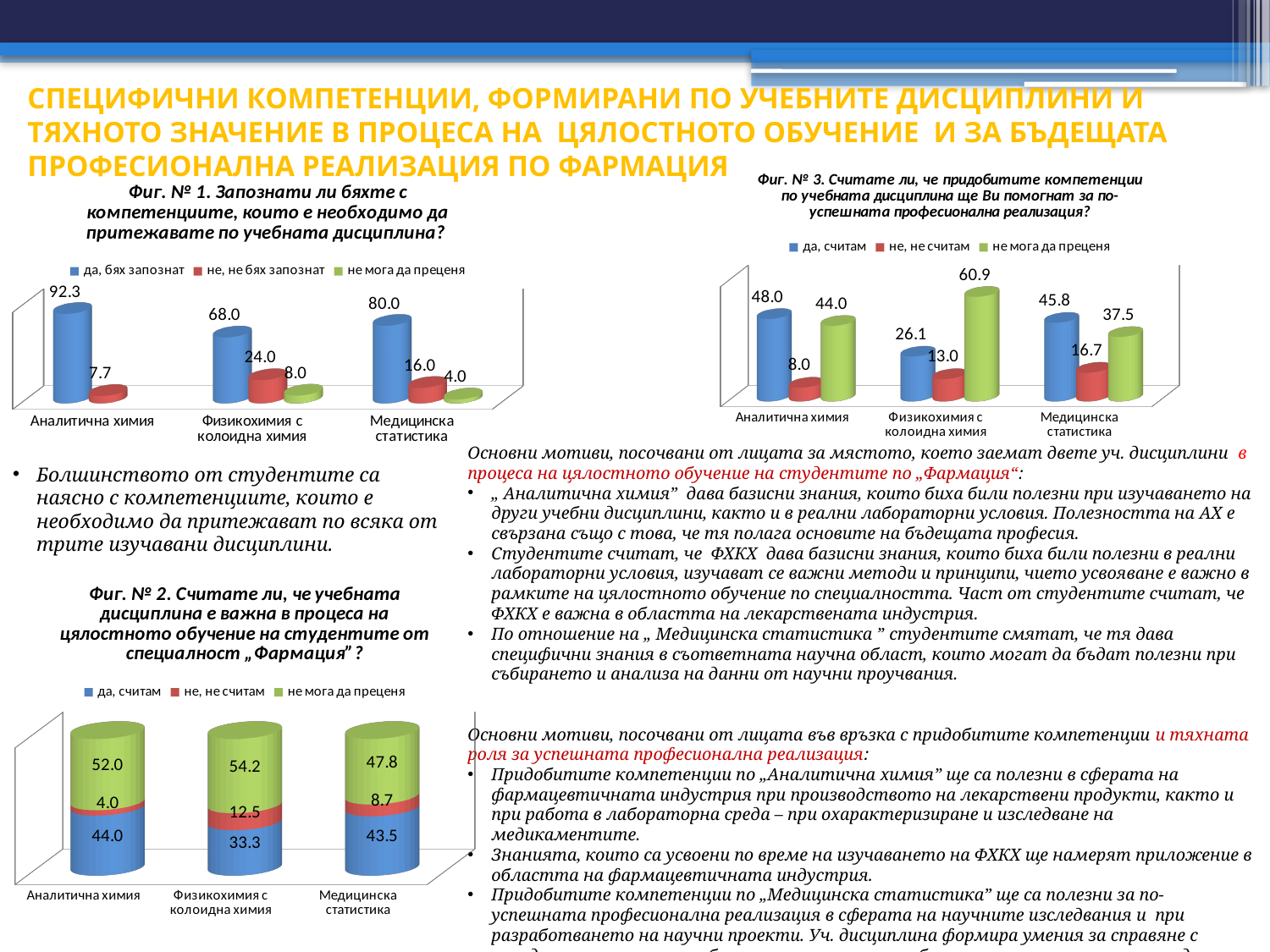
In the chart titled "Фиг. № 2" (bottom left), what is the total of the stacked bar for Аналитична химия? 100.0 In the chart titled "Фиг. № 3" (top right), which is larger for Медицинска статистика: "да, считам" or "не мога да преценя"? да, считам In the chart titled "Фиг. № 1" (top left), which category has the highest value for "да, бях запознат"? Аналитична химия In the chart titled "Фиг. № 1" (top left), what is the difference between the "да, бях запознат" values for Медицинска статистика and Физикохимия с колоидна химия? 12.0 In the chart titled "Фиг. № 2" (bottom left), what is the value of "не, не считам" for Физикохимия с колоидна химия? 12.5 In the chart titled "Фиг. № 3" (top right), how many categories are shown on the x axis? 3 In the chart titled "Фиг. № 1" (top left), how many series does the legend list? 3 What kind of chart is "Фиг. № 2" (bottom left)? Stacked bar chart In the chart titled "Фиг. № 3" (top right), what is the difference between the "не, не считам" values for Медицинска статистика and Аналитична химия? 8.7 In the chart titled "Фиг. № 3" (top right), what is the value of "не мога да преценя" for Физикохимия с колоидна химия? 60.9 In the chart titled "Фиг. № 1" (top left), what is the value of "да, бях запознат" for Аналитична химия? 92.3 In the chart titled "Фиг. № 2" (bottom left), which category has the lowest value for "да, считам"? Физикохимия с колоидна химия